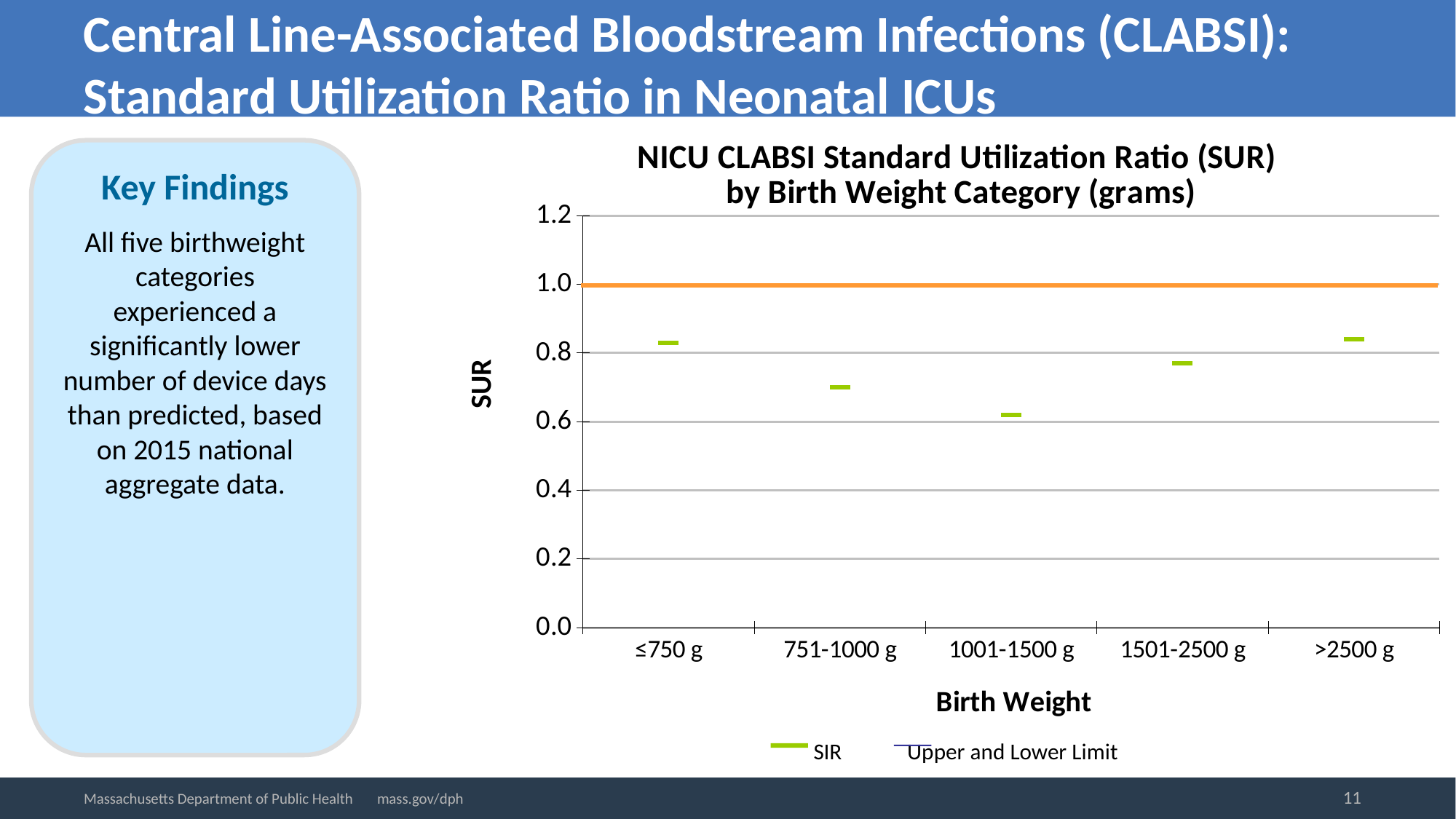
Which has the larger SIR value, 751-1000 g or 1001-1500 g? 751-1000 g Is the SIR value for 1501-2500 g greater or less than 1.0? less How many series does the chart legend list? 2 Which birth weight category has the lowest SIR value in the chart? 1001-1500 g What is the label of the y axis of the chart? SUR Is the SIR value for 1001-1500 g greater or less than 0.8? less Is the SIR value for ≤750 g greater or less than 0.8? greater Which has the larger SIR value, 1001-1500 g or 1501-2500 g? 1501-2500 g How many birth weight categories are shown on the x axis of the chart? 5 At what value on the y axis is the orange 'Upper and Lower Limit' line drawn? 1.0